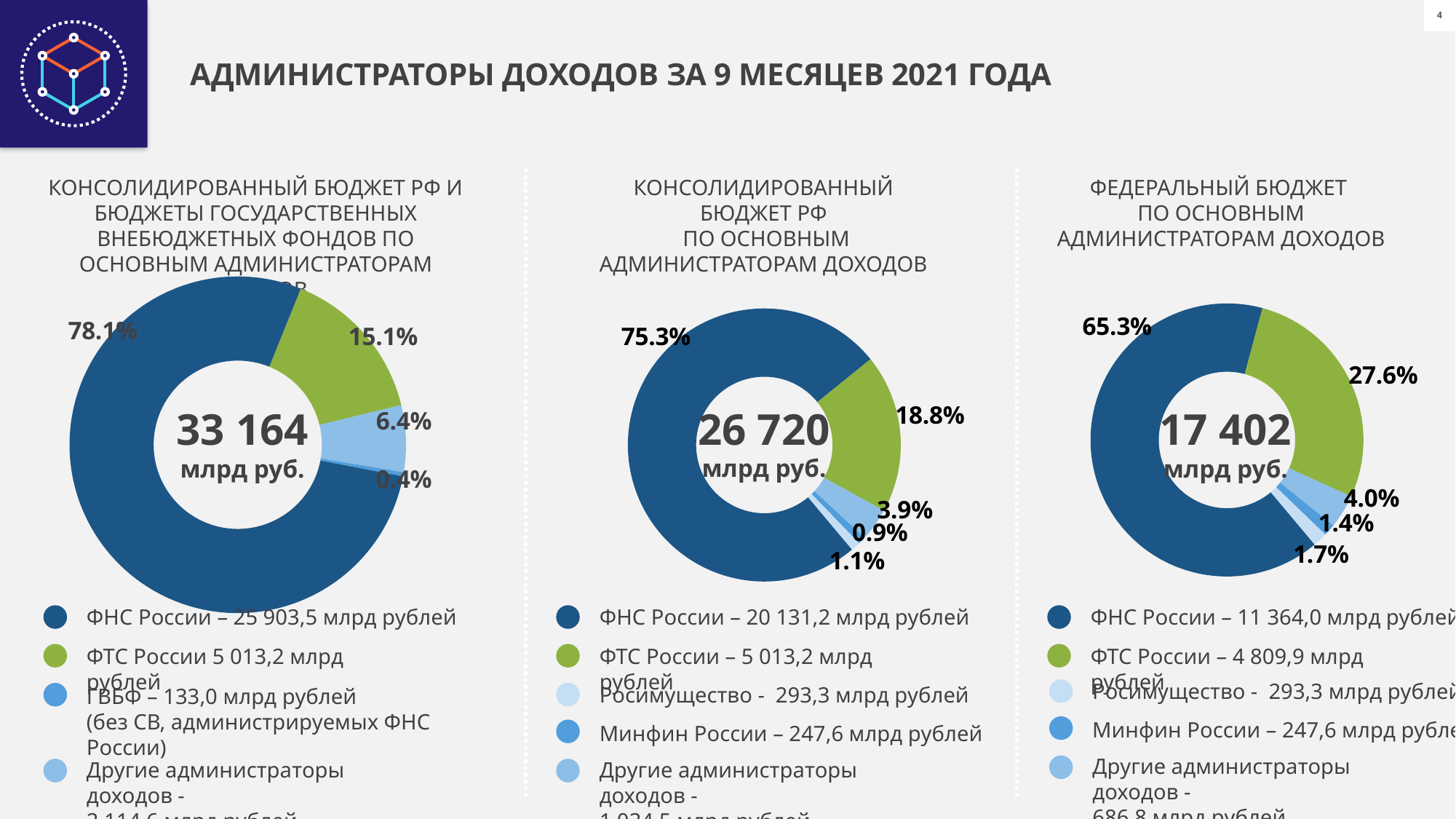
In the right chart, what is the difference between the ФНС России share and the ФТС России share? 37.7% Which is larger: the ФТС России share in the middle chart or in the right chart? Right chart (27.6%) According to the legend of the middle chart, what is the value for ФНС России? 20 131,2 млрд рублей What total value is shown in the centre of the right chart (федеральный бюджет)? 17 402 млрд руб. What total value is shown in the centre of the middle chart (консолидированный бюджет РФ)? 26 720 млрд руб. In the left chart (консолидированный бюджет РФ и бюджеты государственных внебюджетных фондов), what share does ФНС России have? 78.1% In the right chart (федеральный бюджет), what is the smallest percentage shown? 1.4% In the middle chart (консолидированный бюджет РФ), what share does ФТС России have? 18.8% What kind of chart is used on this slide for the three budgets? Pie (donut) chart How many slices does the middle chart (консолидированный бюджет РФ) have? 5 In the left chart, which administrator has the largest share? ФНС России In the right chart (федеральный бюджет), what share does ФНС России have? 65.3%